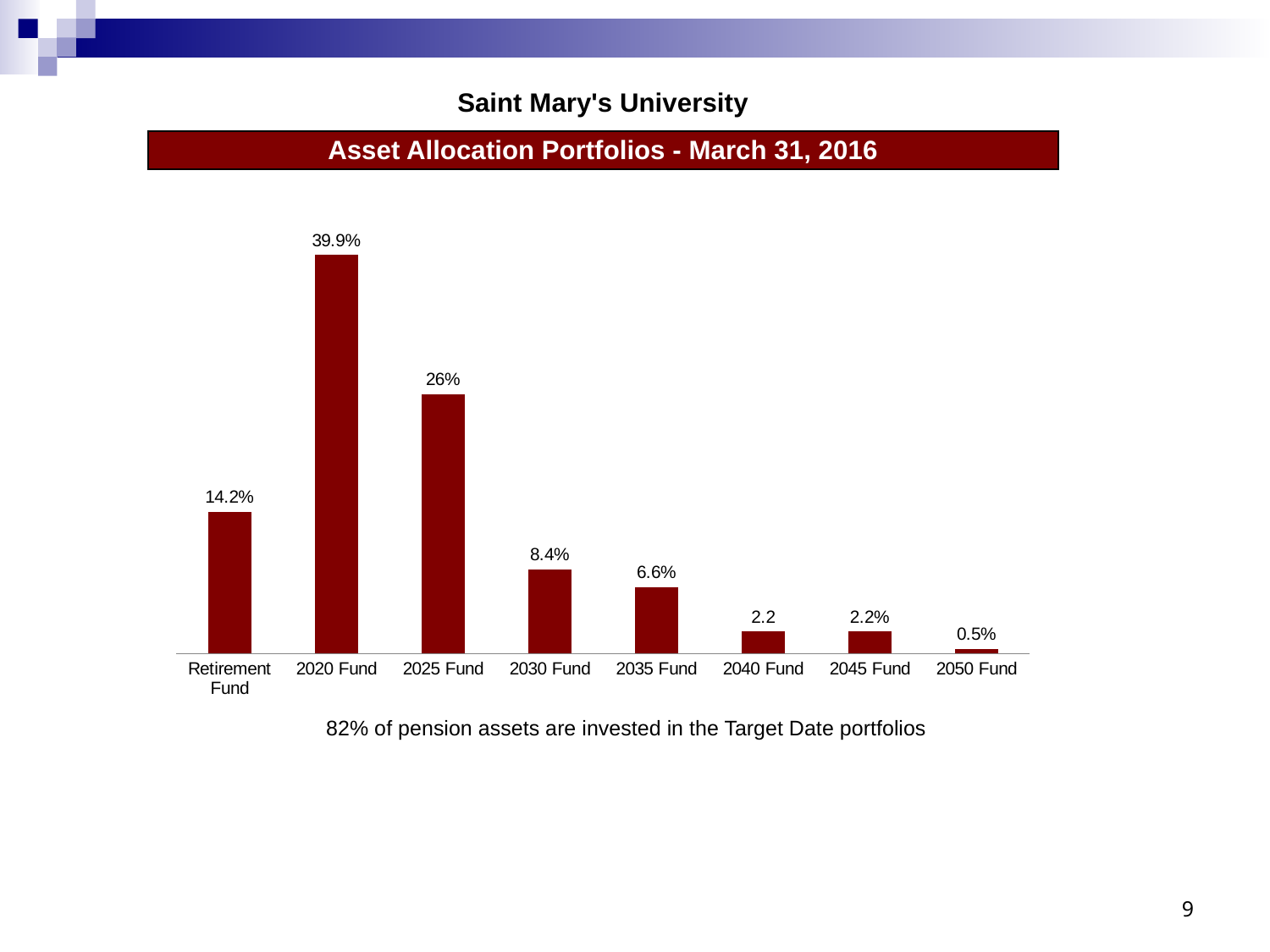
What is the title of the chart? Asset Allocation Portfolios - March 31, 2016 What is the value for the 2030 Fund? 8.4% What is the value for the Retirement Fund? 14.2% Which is larger, the value for the 2035 Fund or the 2030 Fund? 2030 Fund What is the value for the 2020 Fund? 39.9% What is the difference between the 2020 Fund and the 2025 Fund values? 13.9% Which fund has the highest value? 2020 Fund What kind of chart is shown on the slide? Bar chart Which fund has the lowest value? 2050 Fund What is the value for the 2050 Fund? 0.5% How many funds are shown on the chart? 8 What is the difference between the Retirement Fund and the 2030 Fund values? 5.8%